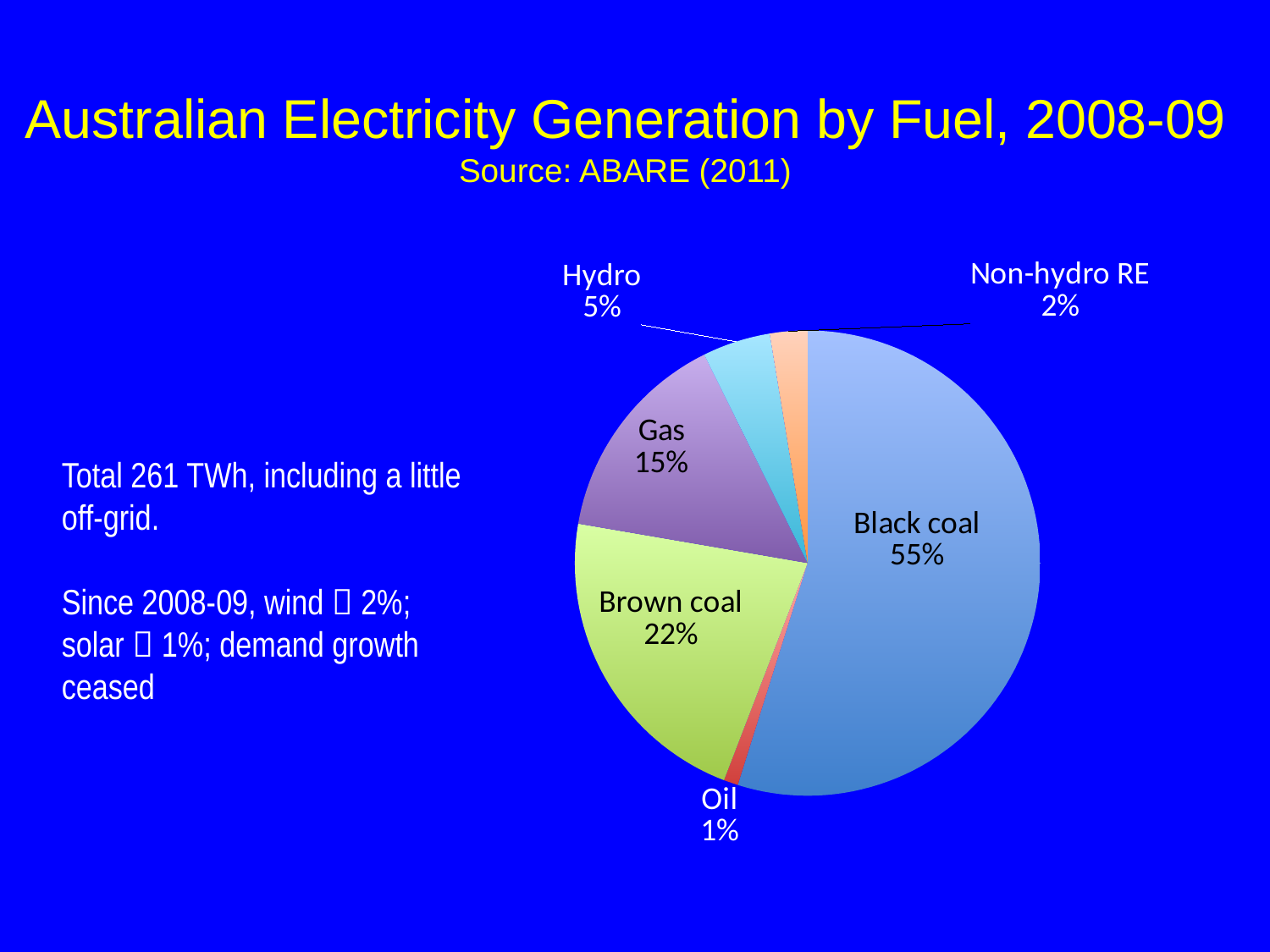
What kind of chart is shown on the slide? pie chart How many percentage points larger is the black coal share than the brown coal share? 33 What share of generation came from gas? 15% Which is larger, the share for gas or the share for hydro? Gas What share of generation came from hydro? 5% What share of generation came from oil? 1% Which fuel has the largest slice of the pie? Black coal What share of Australian electricity generation in 2008-09 came from black coal? 55% What share of generation came from non-hydro RE? 2% Which fuel has the smallest slice of the pie? Oil How many fuel categories are shown in the pie chart? 6 What share of generation came from brown coal? 22%